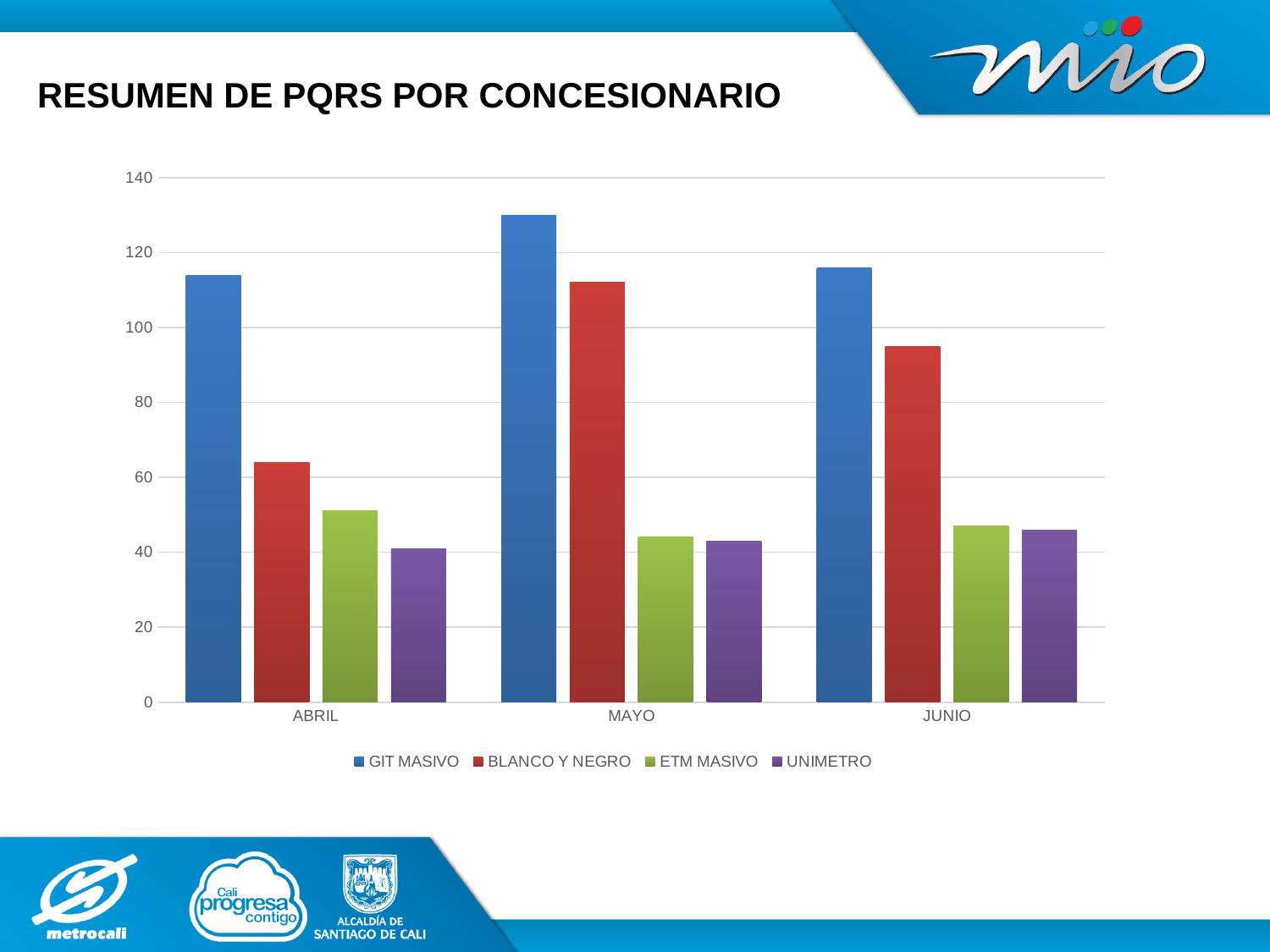
Which series has the tallest bar in every month? GIT MASIVO For BLANCO Y NEGRO, which month has the larger value: MAYO or JUNIO? MAYO Is the value for GIT MASIVO in MAYO greater or less than 120? greater Is the value for BLANCO Y NEGRO in ABRIL greater or less than 80? less What is the title of the slide containing the chart? RESUMEN DE PQRS POR CONCESIONARIO How many months are shown on the x axis? 3 In which month is the GIT MASIVO bar the highest? MAYO What kind of chart is shown on the slide? bar chart Does the BLANCO Y NEGRO value rise or fall from ABRIL to MAYO? rise Which concessionaire has the lowest bar in ABRIL? UNIMETRO How many series does the legend list? 4 In ABRIL, which is larger: GIT MASIVO or BLANCO Y NEGRO? GIT MASIVO